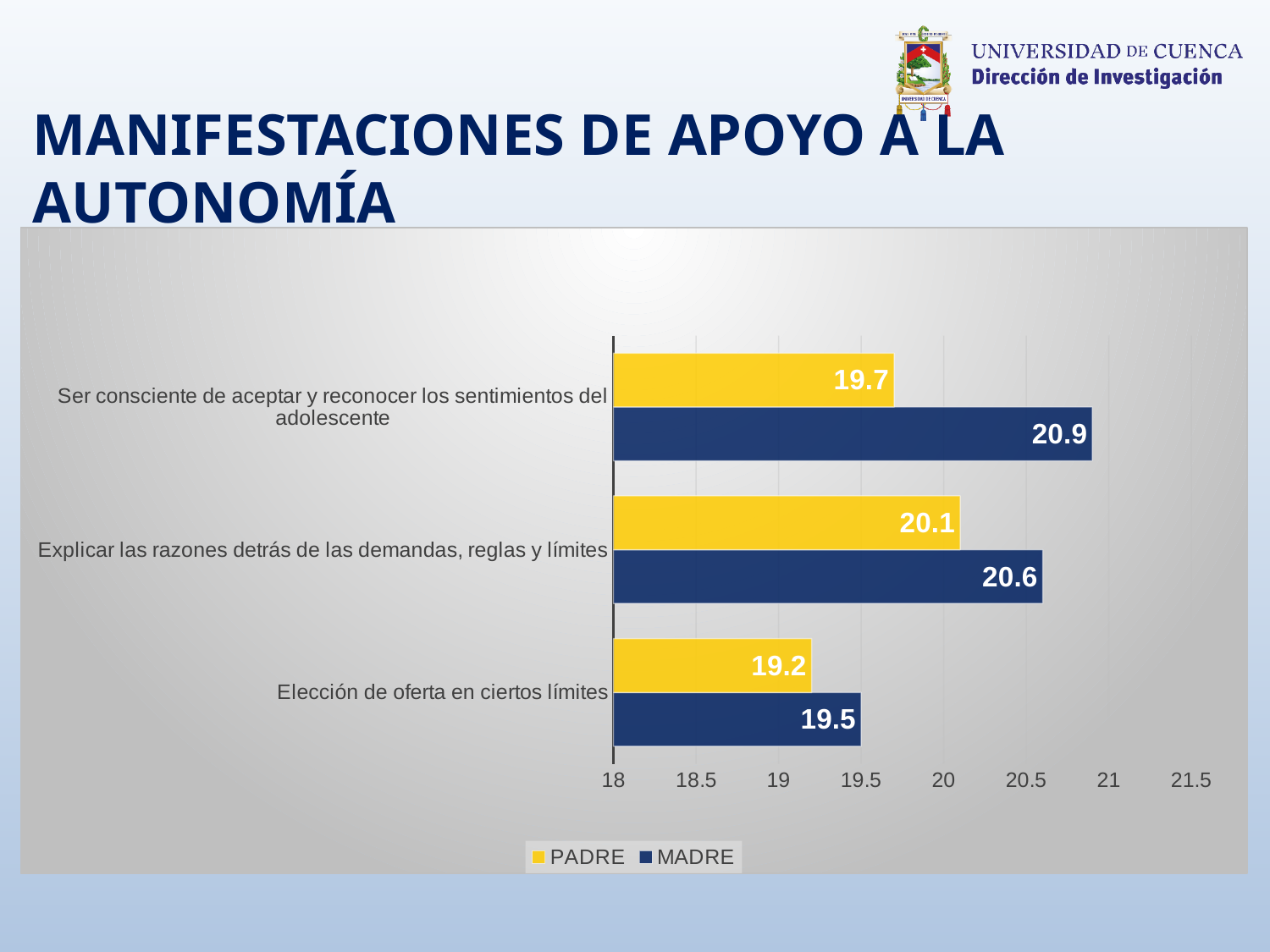
What kind of chart is shown on the slide? Bar chart What is the MADRE value for "Ser consciente de aceptar y reconocer los sentimientos del adolescente"? 20.9 What is the difference between the MADRE and PADRE values for "Ser consciente de aceptar y reconocer los sentimientos del adolescente"? 1.2 What is the PADRE value for "Elección de oferta en ciertos límites"? 19.2 What is the MADRE value for "Elección de oferta en ciertos límites"? 19.5 For "Explicar las razones detrás de las demandas, reglas y límites", which is larger, the PADRE value or the MADRE value? MADRE How many series does the legend list? 2 How many categories are shown on the chart? 3 What is the PADRE value for "Explicar las razones detrás de las demandas, reglas y límites"? 20.1 Which category has the lowest PADRE value? Elección de oferta en ciertos límites Is the MADRE value for "Explicar las razones detrás de las demandas, reglas y límites" greater or less than 20? greater Which category has the highest MADRE value? Ser consciente de aceptar y reconocer los sentimientos del adolescente